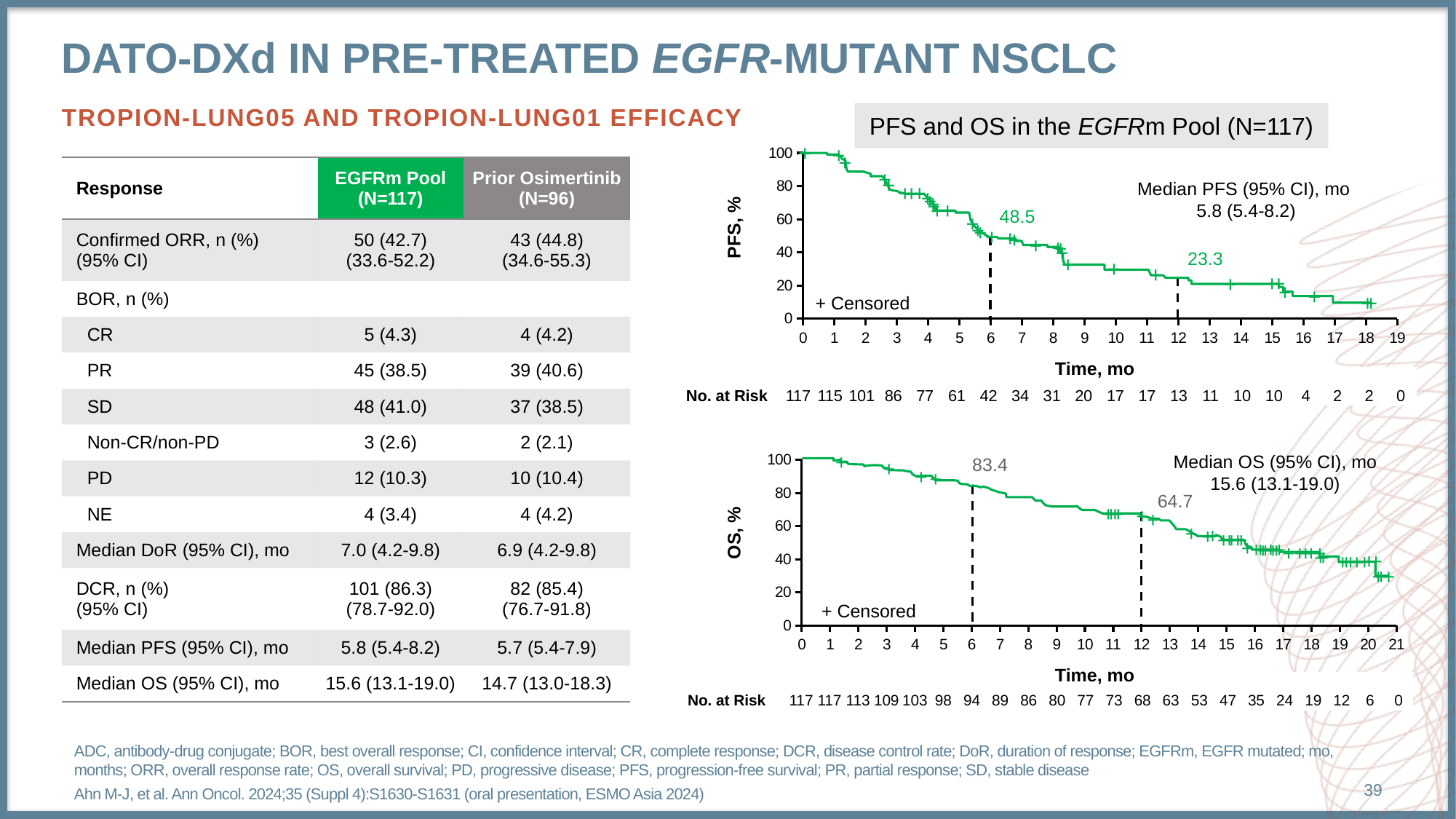
In the PFS chart (top), how many patients are at risk at 6 months? 42 In the PFS chart (top), what is the PFS rate shown at 6 months? 48.5 In the OS chart (bottom), what is the median OS (95% CI) in months? 15.6 (13.1-19.0) In the OS chart (bottom), what is the OS rate shown at 6 months? 83.4 In the OS chart (bottom), is the OS value at 18 months greater or less than 60? less In the OS chart (bottom), what is the difference between the OS rate at 6 months and at 12 months? 18.7 In the PFS chart (top), what is the PFS rate shown at 12 months? 23.3 What kind of chart is the PFS chart (top)? Line chart (Kaplan-Meier curve) In the OS chart (bottom), how many patients are at risk at 12 months? 68 In the OS chart (bottom), what is the OS rate shown at 12 months? 64.7 In the PFS chart (top), what is the median PFS (95% CI) in months? 5.8 (5.4-8.2) In the PFS chart (top), what is the difference between the PFS rate at 6 months and at 12 months? 25.2